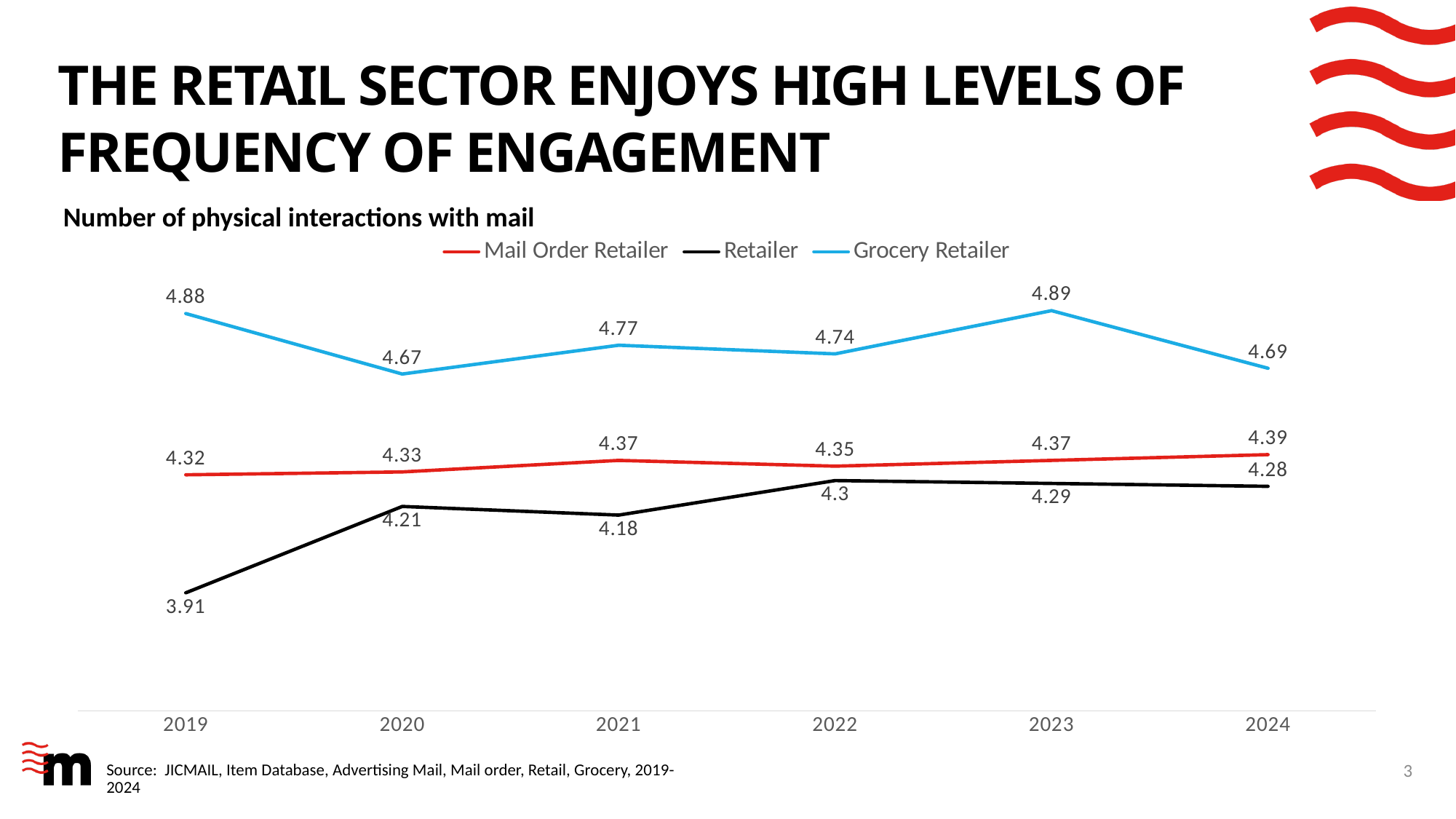
In which year is the Grocery Retailer value highest? 2023 What is the value for Grocery Retailer in 2019? 4.88 What is the difference between the Grocery Retailer and Retailer values in 2019? 0.97 What kind of chart is shown on the slide? Line chart Which series is drawn in blue? Grocery Retailer Does the Retailer value rise or fall from 2019 to 2020? Rise What is the value for Mail Order Retailer in 2024? 4.39 How many years are shown on the x axis? 6 How many series does the legend list? 3 Which is larger in 2022, the Mail Order Retailer value or the Retailer value? Mail Order Retailer In which year is the Retailer value lowest? 2019 What is the value for Retailer in 2021? 4.18